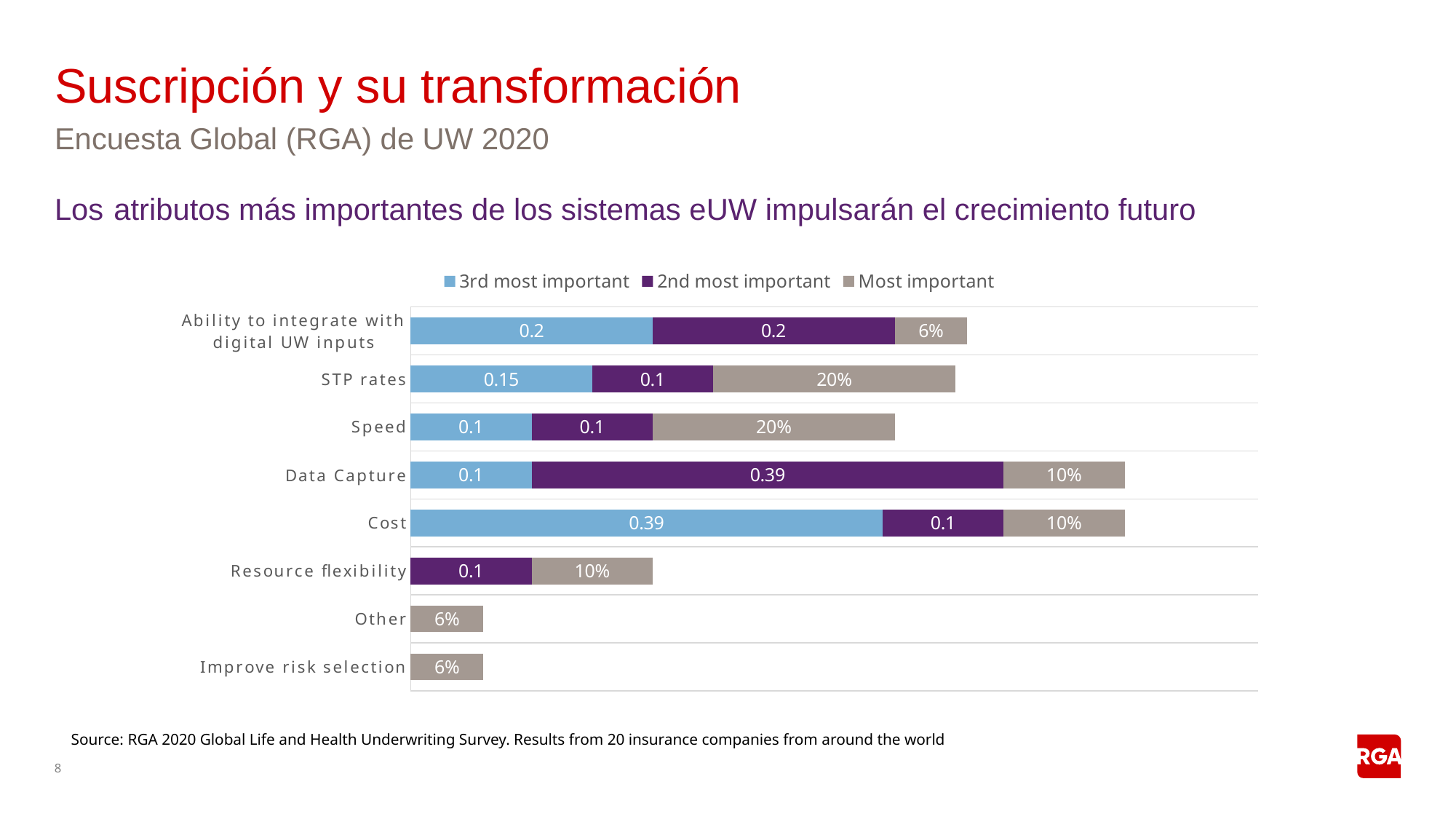
What is the difference between the '2nd most important' values for Data Capture and Speed? 0.29 Which legend entry is shown in grey? Most important What is the '3rd most important' value for Cost? 0.39 Is the 'Most important' value larger for Data Capture or for Ability to integrate with digital UW inputs? Data Capture What is the 'Most important' value for Improve risk selection? 6% What is the '2nd most important' value for Data Capture? 0.39 What kind of chart is shown on the slide? Stacked bar chart What is the 'Most important' value for STP rates? 20% Which category has the highest '2nd most important' value? Data Capture How many series does the legend list? 3 How many categories are plotted on the chart? 8 Which category has the highest '3rd most important' value? Cost